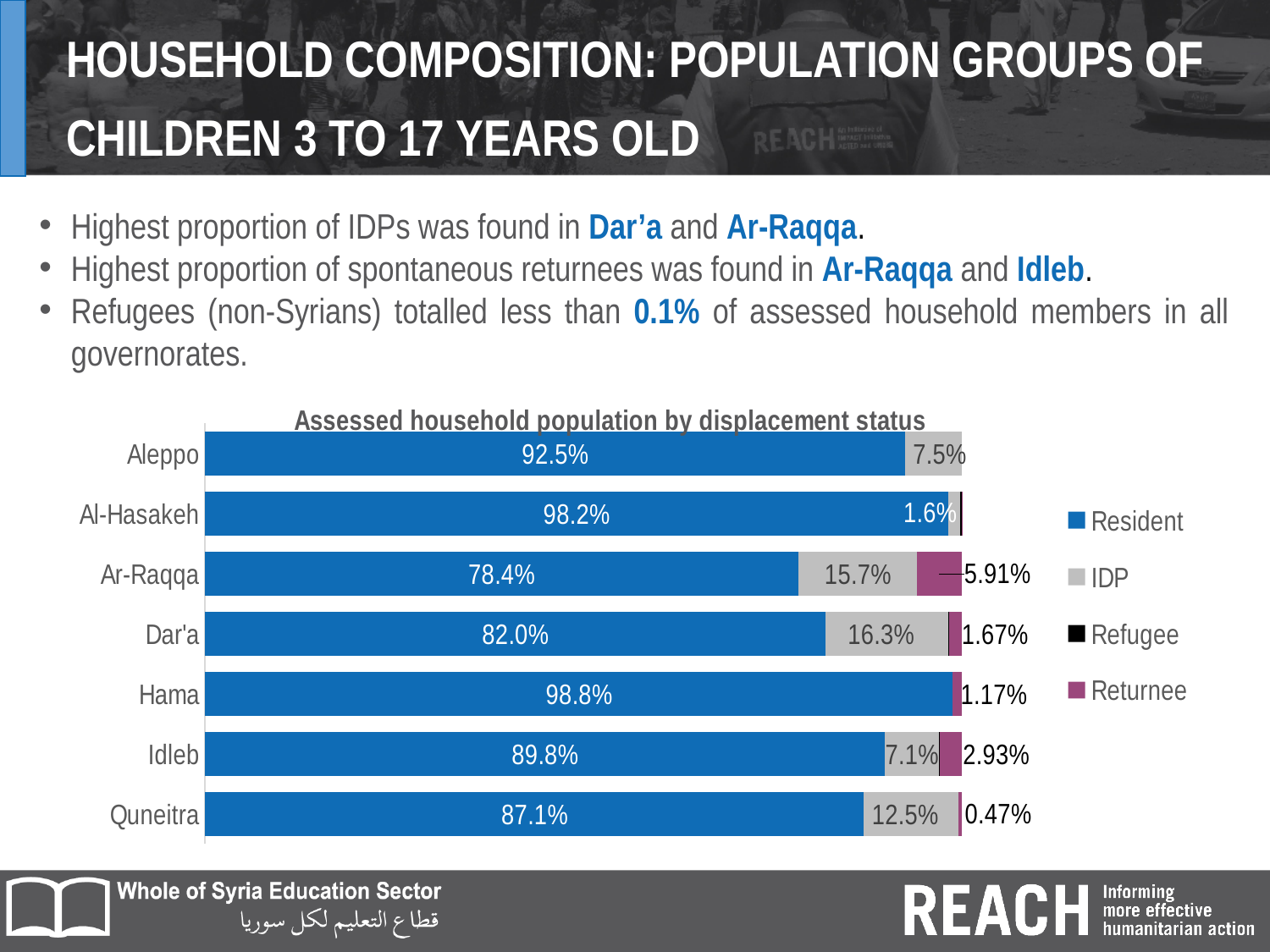
What is the IDP share for Dar'a? 16.3% What is the IDP share for Quneitra? 12.5% What is the Returnee share for Ar-Raqqa? 5.91% What is the difference between the Resident share for Hama and the Resident share for Ar-Raqqa? 20.4 percentage points Which governorate has the lowest Resident share? Ar-Raqqa How many series does the legend list? 4 Which governorate has the highest Resident share? Hama What is the Resident share for Aleppo? 92.5% Which is larger, the IDP share for Aleppo or the IDP share for Idleb? Aleppo How many governorates are shown in the chart? 7 What is the title of the chart? Assessed household population by displacement status What kind of chart is shown on the slide? Stacked bar chart